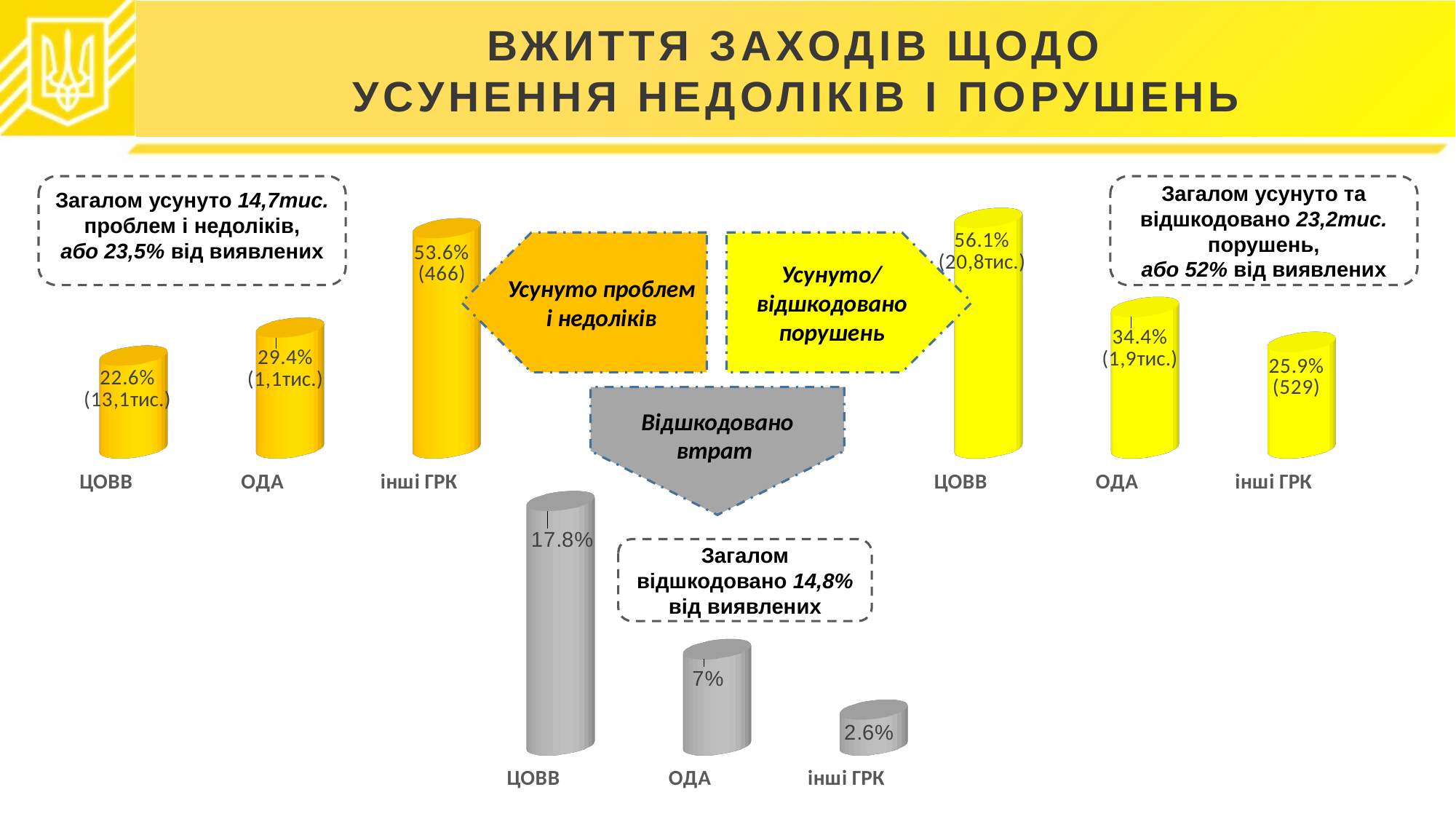
In the left chart (Усунуто проблем і недоліків), what percentage is shown for інші ГРК? 53.6% How many categories does the bottom chart (Відшкодовано втрат) show? 3 In the left chart (Усунуто проблем і недоліків), which category has the lowest percentage? ЦОВВ In the bottom chart (Відшкодовано втрат), what percentage is shown for ЦОВВ? 17.8% In the right chart (Усунуто/відшкодовано порушень), which category has the lowest percentage? інші ГРК In the right chart (Усунуто/відшкодовано порушень), what percentage is shown for ЦОВВ? 56.1% In the bottom chart (Відшкодовано втрат), what is the difference in percentage points between ЦОВВ and ОДА? 10.8 In the bottom chart (Відшкодовано втрат), what percentage is shown for інші ГРК? 2.6% In the left chart (Усунуто проблем і недоліків), what percentage is shown for ЦОВВ? 22.6% What type of chart is the right chart (Усунуто/відшкодовано порушень)? bar chart In the left chart (Усунуто проблем і недоліків), which category has the highest percentage? інші ГРК In the right chart (Усунуто/відшкодовано порушень), what percentage is shown for ОДА? 34.4%